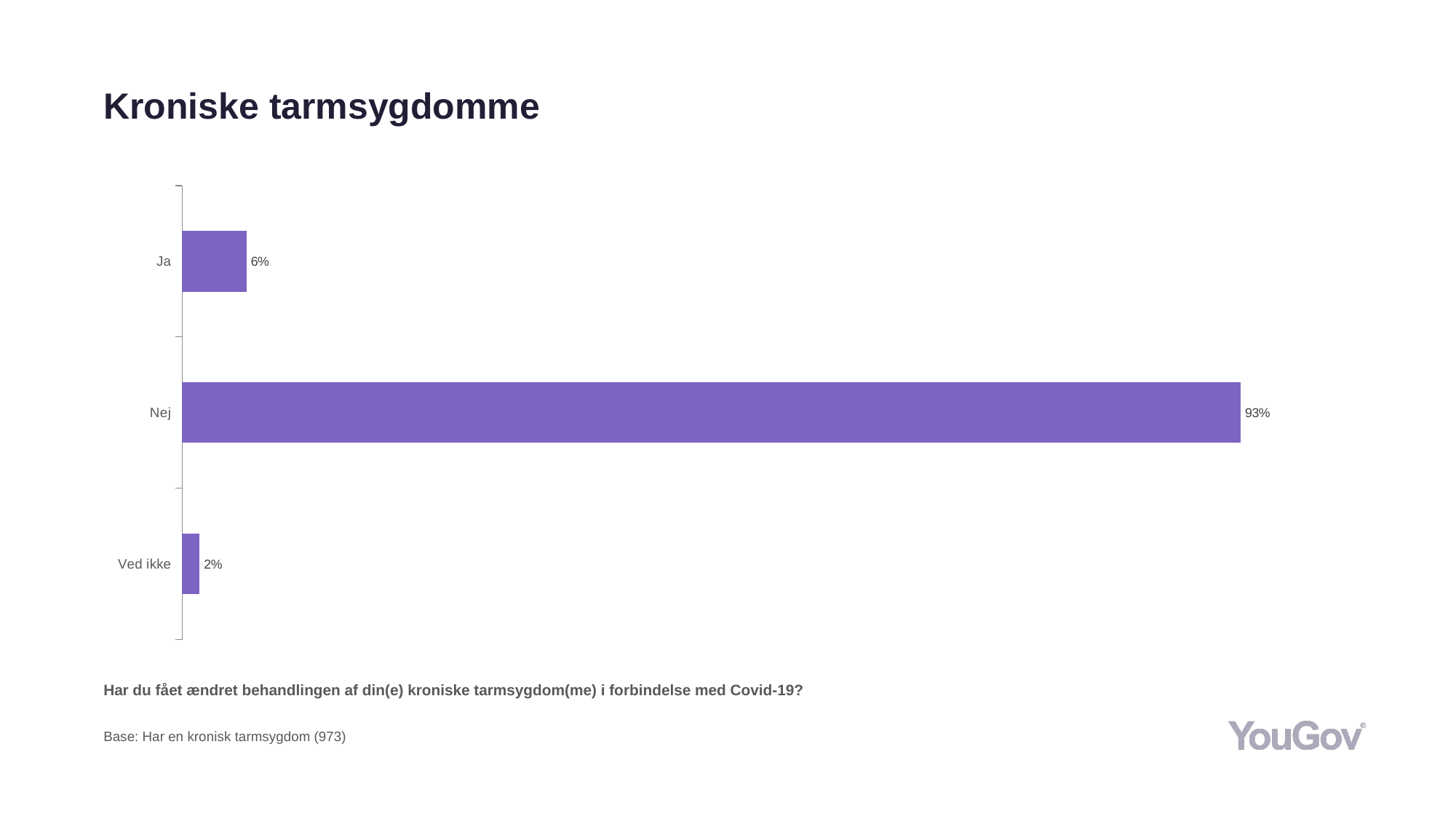
What is the difference between the values for "Nej" and "Ja"? 87% What is the value for "Nej"? 93% Which is larger, the value for "Ja" or the value for "Ved ikke"? Ja What is the difference between the values for "Ja" and "Ved ikke"? 4% What is the title of the slide? Kroniske tarmsygdomme What is the base size stated below the chart? 973 What is the value for "Ved ikke"? 2% Which category has the highest value? Nej How many categories are shown in the chart? 3 What is the value for "Ja"? 6% Which category has the lowest value? Ved ikke What kind of chart is shown on the slide? Bar chart